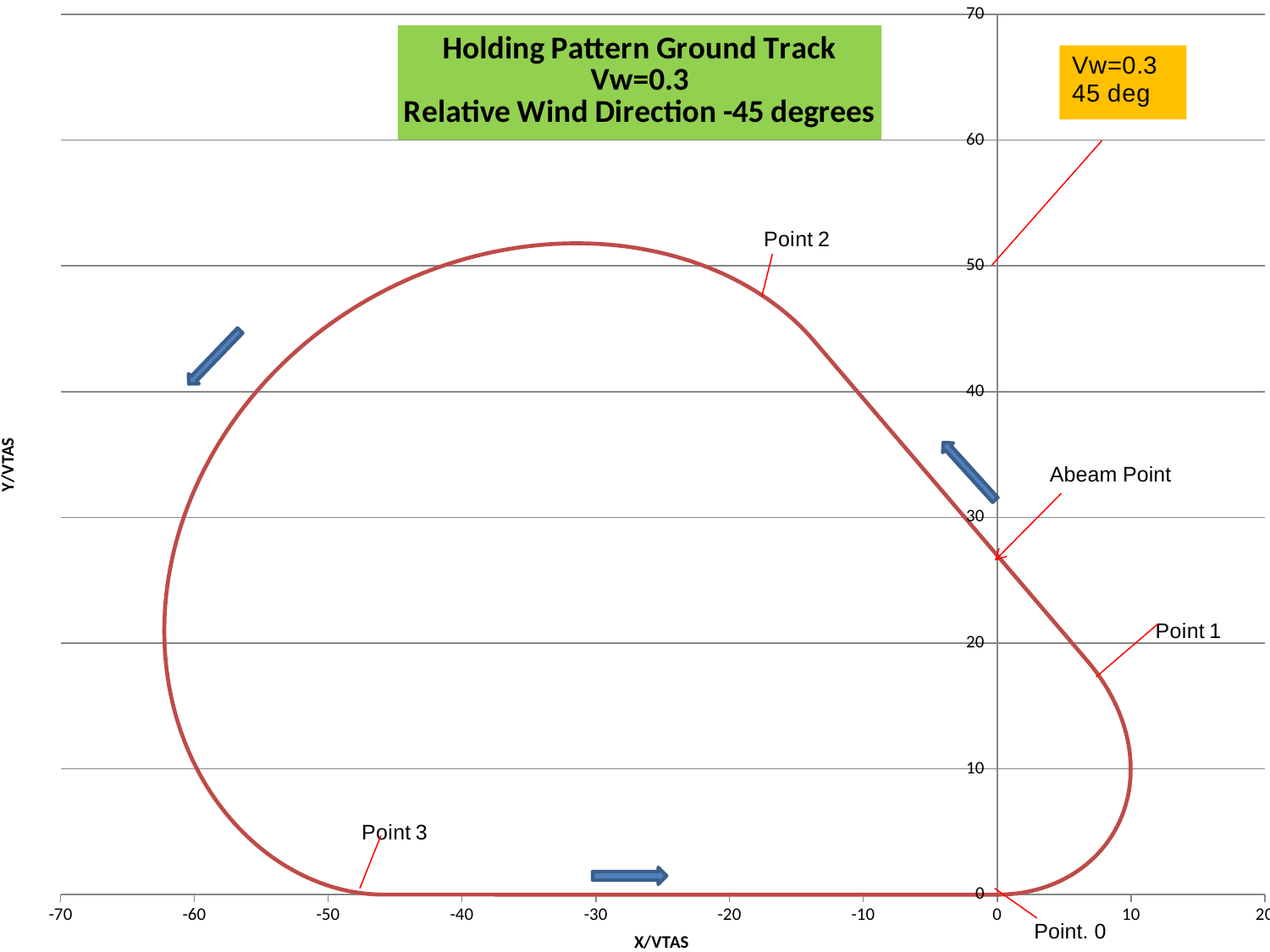
Is the X/VTAS value at Point 1 greater or less than 0? greater What is the label of the x axis? X/VTAS What is the title of the chart? Holding Pattern Ground Track Vw=0.3 Relative Wind Direction -45 degrees What kind of chart is shown on the slide? line chart Is the X/VTAS value at Point 3 greater or less than -40? less What is the Y/VTAS value at Point 0? 0 Is the Y/VTAS value at the Abeam Point greater or less than 30? less What is the Y/VTAS value at Point 3? 0 What is the X/VTAS value at Point 0? 0 How many labeled points (including the Abeam Point) are marked on the track? 5 Which labeled point has the higher Y/VTAS value, Point 2 or Point 1? Point 2